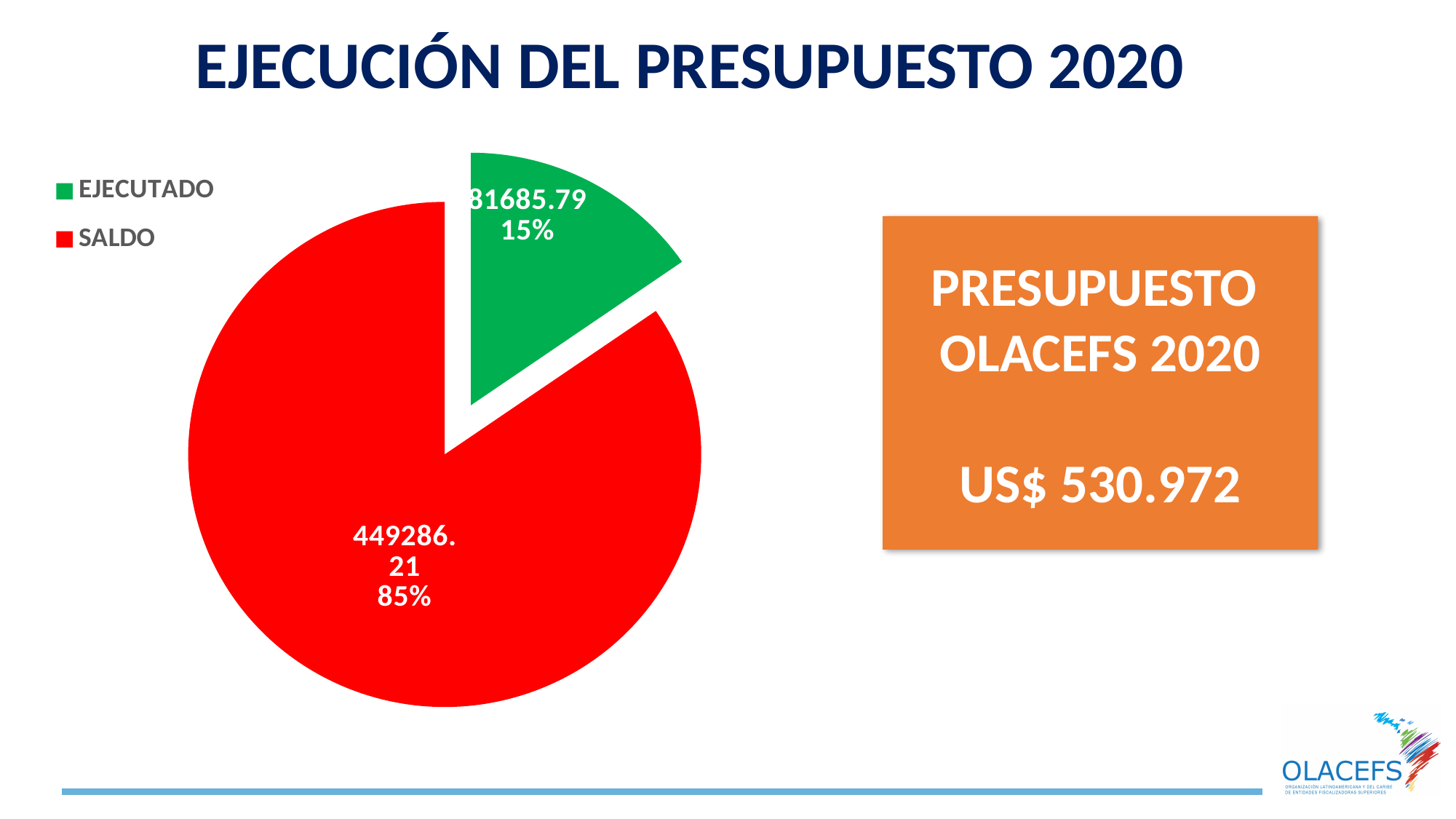
What percentage share of the pie does SALDO represent? 85% What is the value shown for EJECUTADO in the pie chart? 81685.79 What is the value shown for SALDO in the pie chart? 449286.21 How many slices does the pie chart have? 2 What kind of chart is shown on the slide? Pie chart Which is larger, the value for SALDO or the value for EJECUTADO? SALDO What percentage share of the pie does EJECUTADO represent? 15% What colour is the EJECUTADO slice in the pie chart? Green Which slice of the pie chart is the largest? SALDO Which slice of the pie chart is the smallest? EJECUTADO What is the difference between the SALDO value and the EJECUTADO value? 367600.42 How many entries does the chart legend list? 2